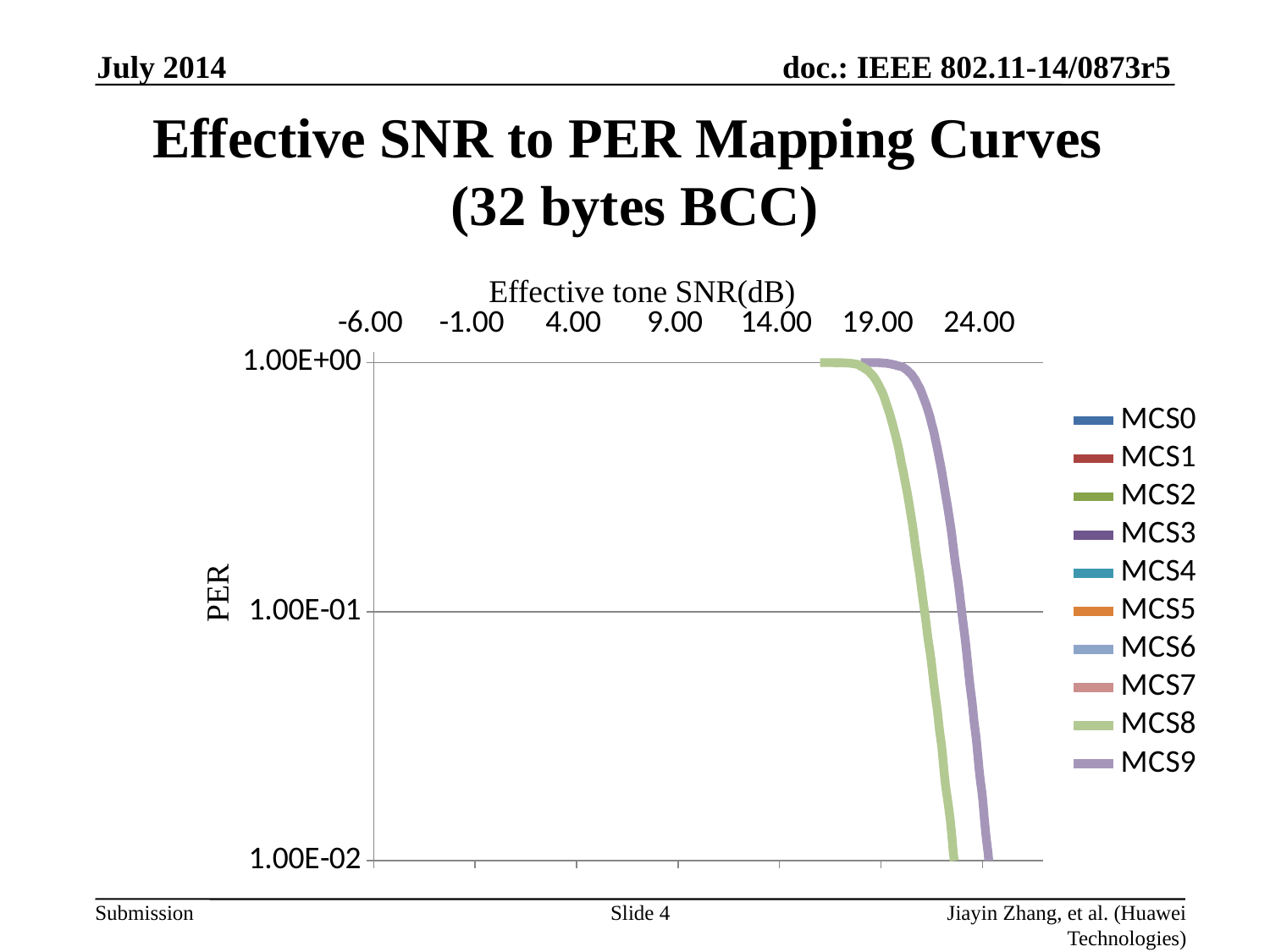
Is the SNR at which the MCS8 curve crosses a PER of 1.00E-01 greater or less than 19.00? greater How many curves are actually visible in the plot area? 2 What is the label of the x axis? Effective tone SNR(dB) What kind of chart is shown on the slide? line chart Is the SNR at which the MCS8 curve reaches a PER of 1.00E-02 greater or less than 24.00? less How many series does the legend list? 10 What is the lowest PER value labelled on the y axis? 1.00E-02 What is the label of the y axis? PER Is the SNR at which the MCS9 curve crosses a PER of 1.00E-01 greater or less than 24.00? less Which visible curve reaches a PER of 1.00E-01 at the higher SNR, MCS8 or MCS9? MCS9 Does PER rise or fall as the effective tone SNR increases along the x axis? fall Which visible curve lies furthest to the right on the chart? MCS9